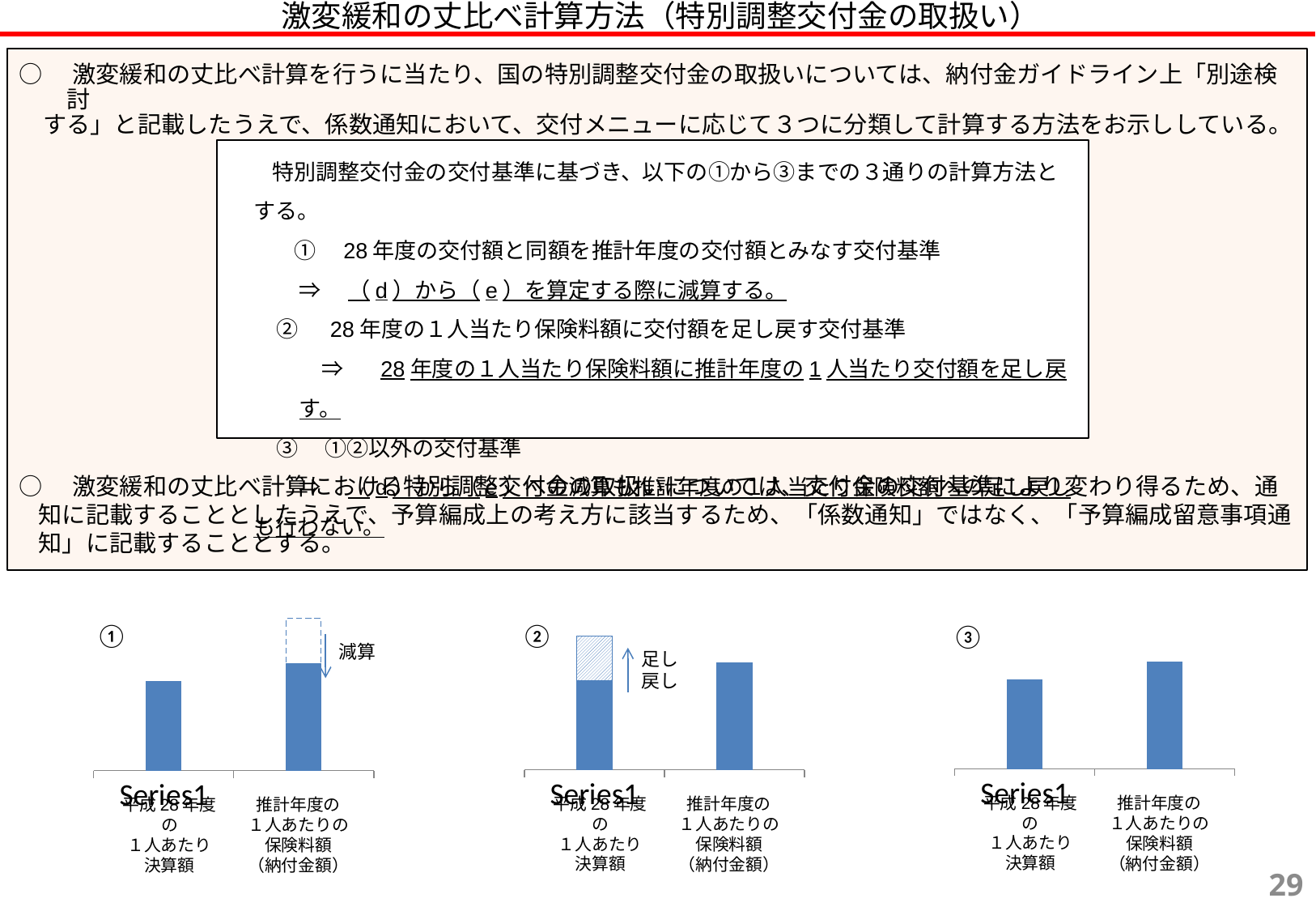
What kind of chart is chart ③ at the bottom right of the slide? bar chart In chart ③ at the bottom right, which category has the lowest bar? 平成28年度の1人あたり決算額 In chart ② in the bottom middle, what annotation text is written next to the upward arrow on the first bar? 足し戻し In chart ① at the bottom left, what annotation text is written next to the downward arrow on the second bar? 減算 In chart ① at the bottom left, which bar is taller: 平成28年度の1人あたり決算額 or 推計年度の1人あたりの保険料額（納付金額）? 推計年度の1人あたりの保険料額（納付金額） How many bars (categories) are plotted in chart ③ at the bottom right? 2 What kind of chart is chart ① at the bottom left of the slide? bar chart How many bars (categories) are plotted in chart ② in the bottom middle? 2 In chart ③ at the bottom right, which bar is taller: 平成28年度の1人あたり決算額 or 推計年度の1人あたりの保険料額（納付金額）? 推計年度の1人あたりの保険料額（納付金額） How many bars (categories) are plotted in chart ① at the bottom left? 2